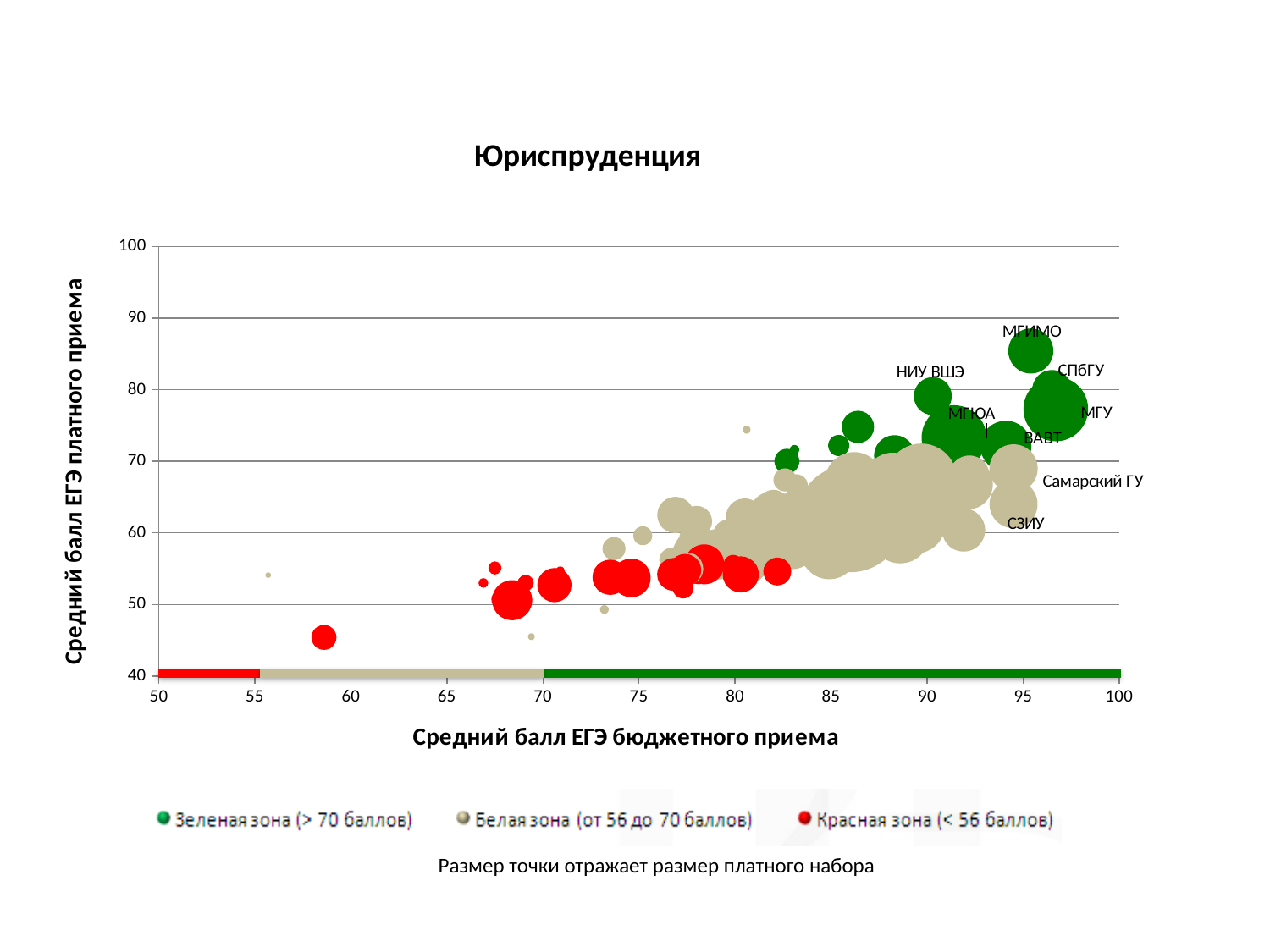
What kind of chart is shown on the slide? bubble chart Which has the higher x-axis value (Средний балл ЕГЭ бюджетного приема), НИУ ВШЭ or СПбГУ? СПбГУ What is the title of the chart? Юриспруденция Which has the higher y-axis value (Средний балл ЕГЭ платного приема), МГИМО or МГУ? МГИМО Which labeled university has the highest value on the y axis (Средний балл ЕГЭ платного приема)? МГИМО Is the x-axis value (Средний балл ЕГЭ бюджетного приема) for МГУ greater or less than 95? greater Is the y-axis value (Средний балл ЕГЭ платного приема) for СЗИУ greater or less than 70? less Is the y-axis value (Средний балл ЕГЭ платного приема) for МГИМО greater or less than 80? greater Do the y-axis values generally rise or fall as the x-axis value increases? rise How many series does the legend list? 3 What is the label of the x axis? Средний балл ЕГЭ бюджетного приема